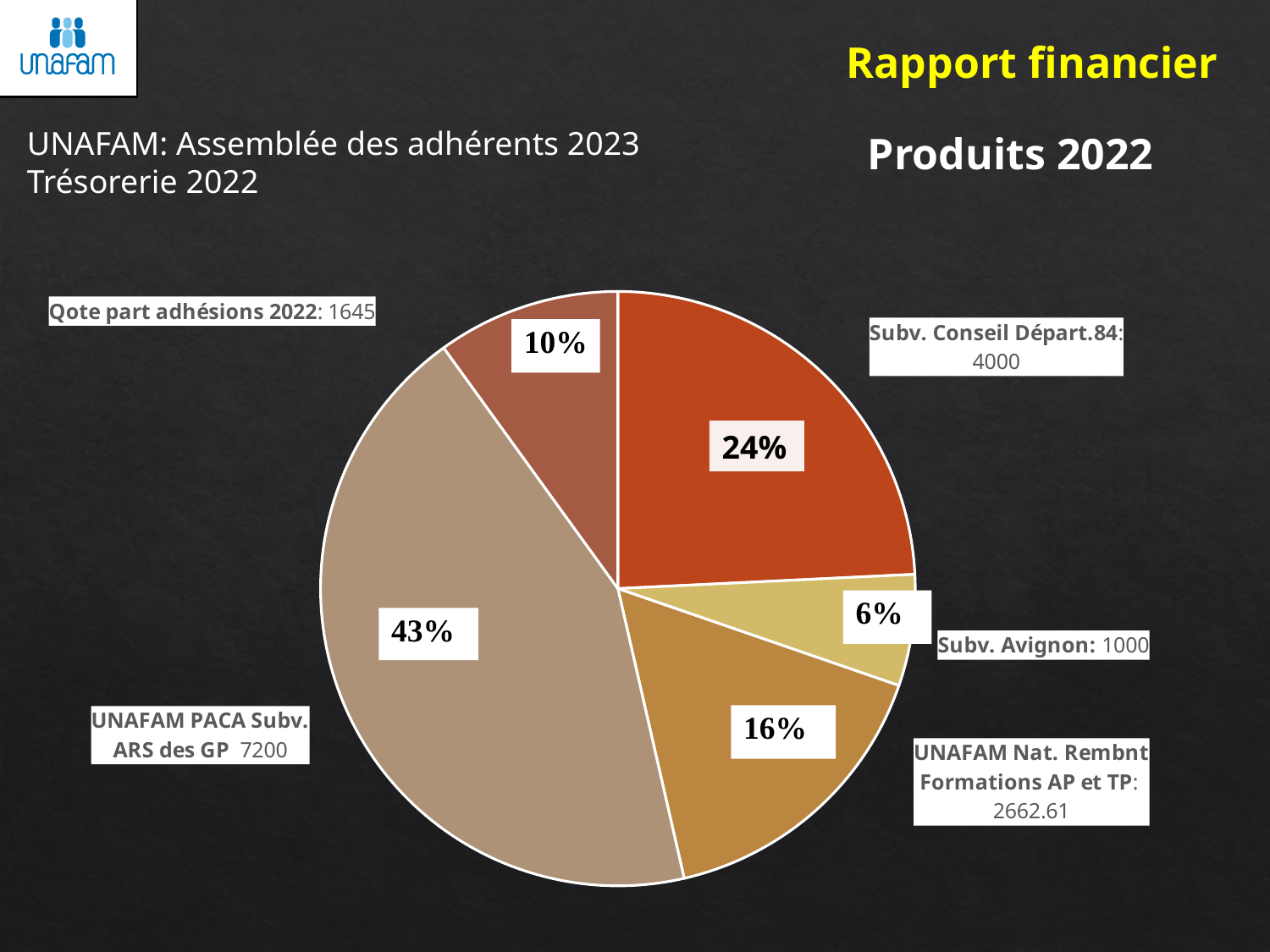
Which category has the largest slice? UNAFAM PACA Subv. ARS des GP Which category has the smallest slice? Subv. Avignon What is the value for Qote part adhésions 2022? 1645 What share of the pie does UNAFAM PACA Subv. ARS des GP represent? 43% What is the value for Subv. Conseil Départ.84? 4000 How many slices does the pie chart have? 5 What is the difference between the values for UNAFAM PACA Subv. ARS des GP and Subv. Conseil Départ.84? 3200 What kind of chart is shown on the slide? pie chart What is the value for Subv. Avignon? 1000 What is the value for UNAFAM Nat. Rembnt Formations AP et TP? 2662.61 What is the value for UNAFAM PACA Subv. ARS des GP? 7200 What share of the pie does Subv. Avignon represent? 6%